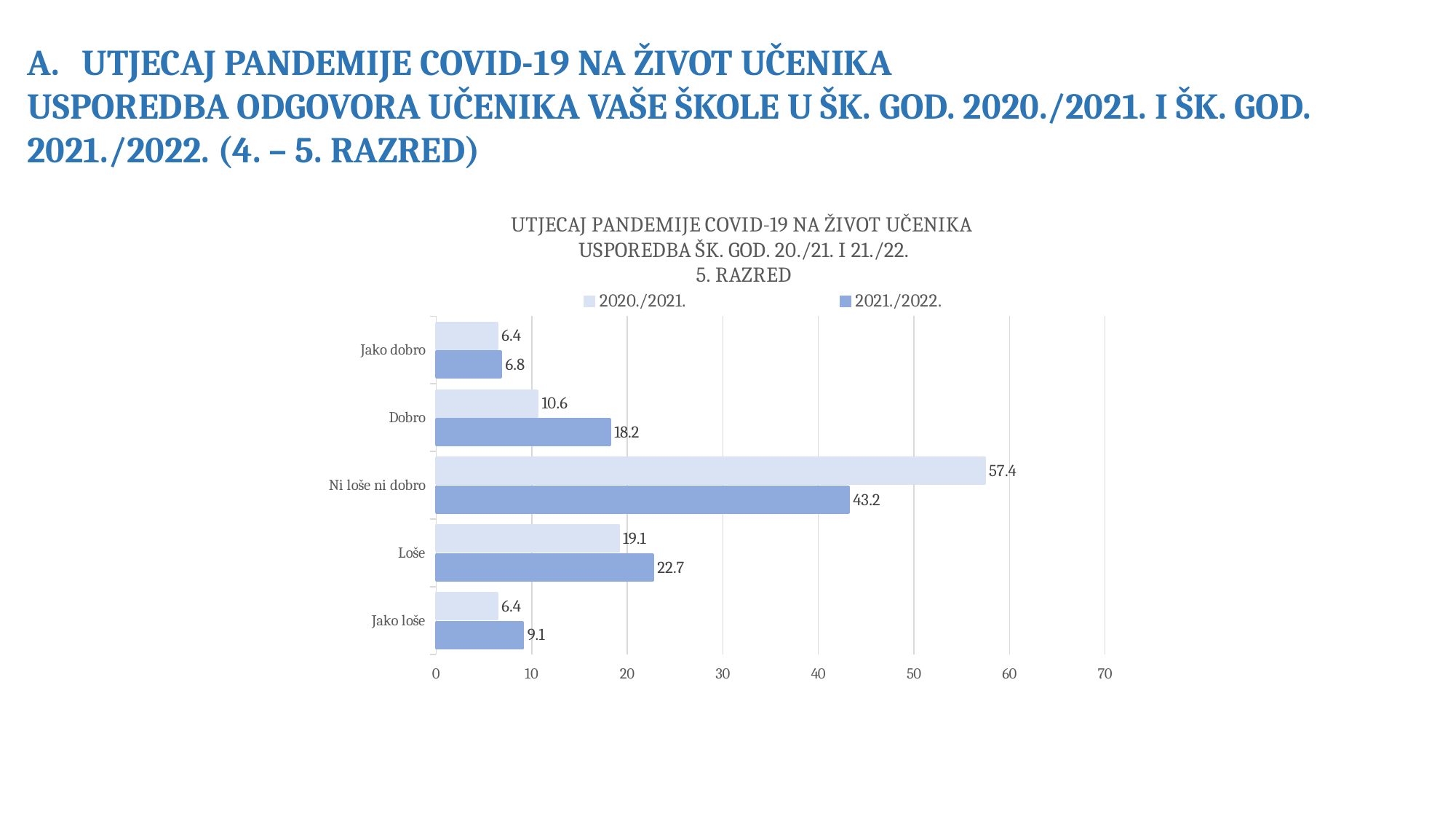
What is the value for "Dobro" in the 2021./2022. series? 18.2 What is the value for "Loše" in the 2021./2022. series? 22.7 What is the difference between the 2020./2021. and 2021./2022. values for "Ni loše ni dobro"? 14.2 Which series is shown in the darker blue colour? 2021./2022. For "Jako loše", which series has the larger value, 2020./2021. or 2021./2022.? 2021./2022. How many series does the legend list? 2 What kind of chart is shown on the slide? Bar chart What is the difference between the 2021./2022. and 2020./2021. values for "Dobro"? 7.6 Which category has the lowest value in the 2021./2022. series? Jako dobro How many categories are shown on the chart? 5 Which category has the highest value in the 2021./2022. series? Ni loše ni dobro What is the value for "Ni loše ni dobro" in the 2020./2021. series? 57.4